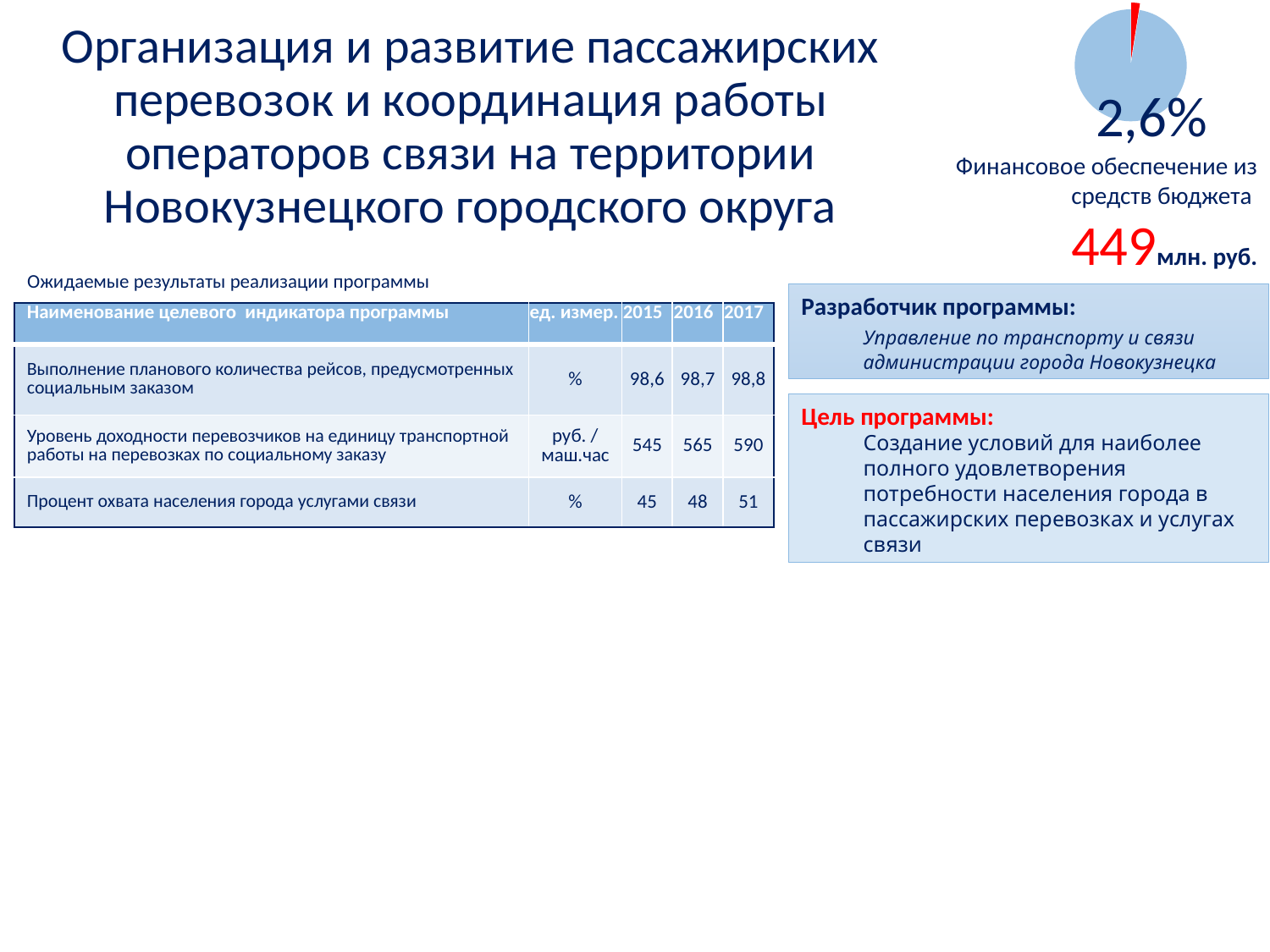
What kind of chart is shown in the top right corner of the slide? pie chart How many slices does the pie chart have? 2 Is the share shown by the small slice of the pie chart greater or less than 50%? less What share of the pie chart does the small red slice represent? 2,6% What colour is the small slice of the pie chart? red What amount in million rubles is printed below the pie chart as the budget financing? 449 млн. руб.